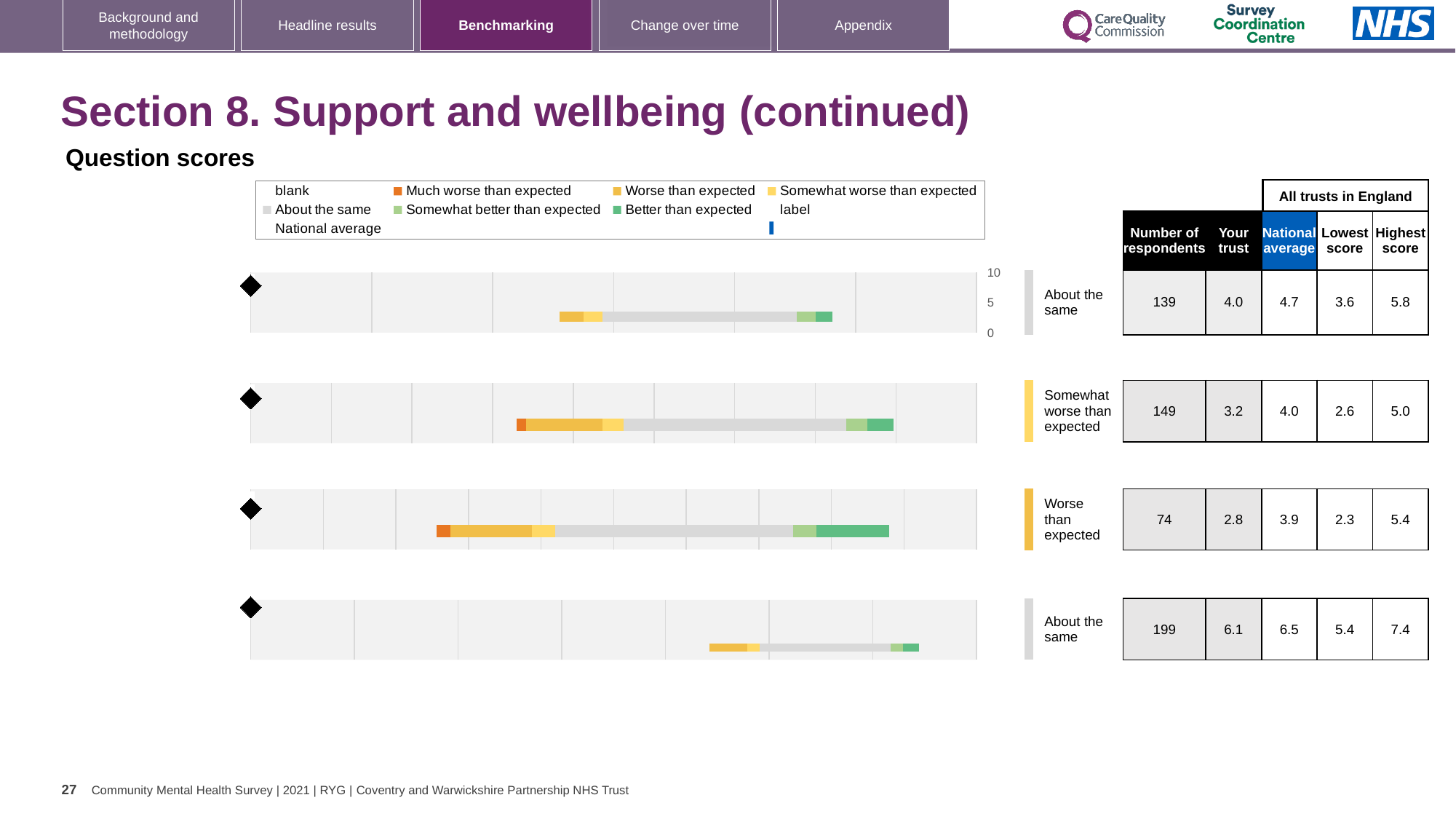
How many question score charts are shown on the slide? 4 What kind of chart is used to show the question scores on this slide? Bar chart On the first (top) chart, what is the 'Your trust' score? 4.0 What benchmark rating is given to the third chart? Worse than expected Which of the four charts has the highest 'Your trust' score? The fourth (bottom) chart, 6.1 On the second chart, which is larger: the 'Your trust' score or the national average? National average Which of the four charts has the lowest number of respondents? The third chart, 74 On the fourth (bottom) chart, what is the highest score among all trusts in England? 7.4 On the third chart, what is the difference between the national average and the 'Your trust' score? 1.1 On the second chart, what is the lowest score among all trusts in England? 2.6 On the third chart, what is the national average score? 3.9 On the second chart, how many respondents are shown in the table? 149